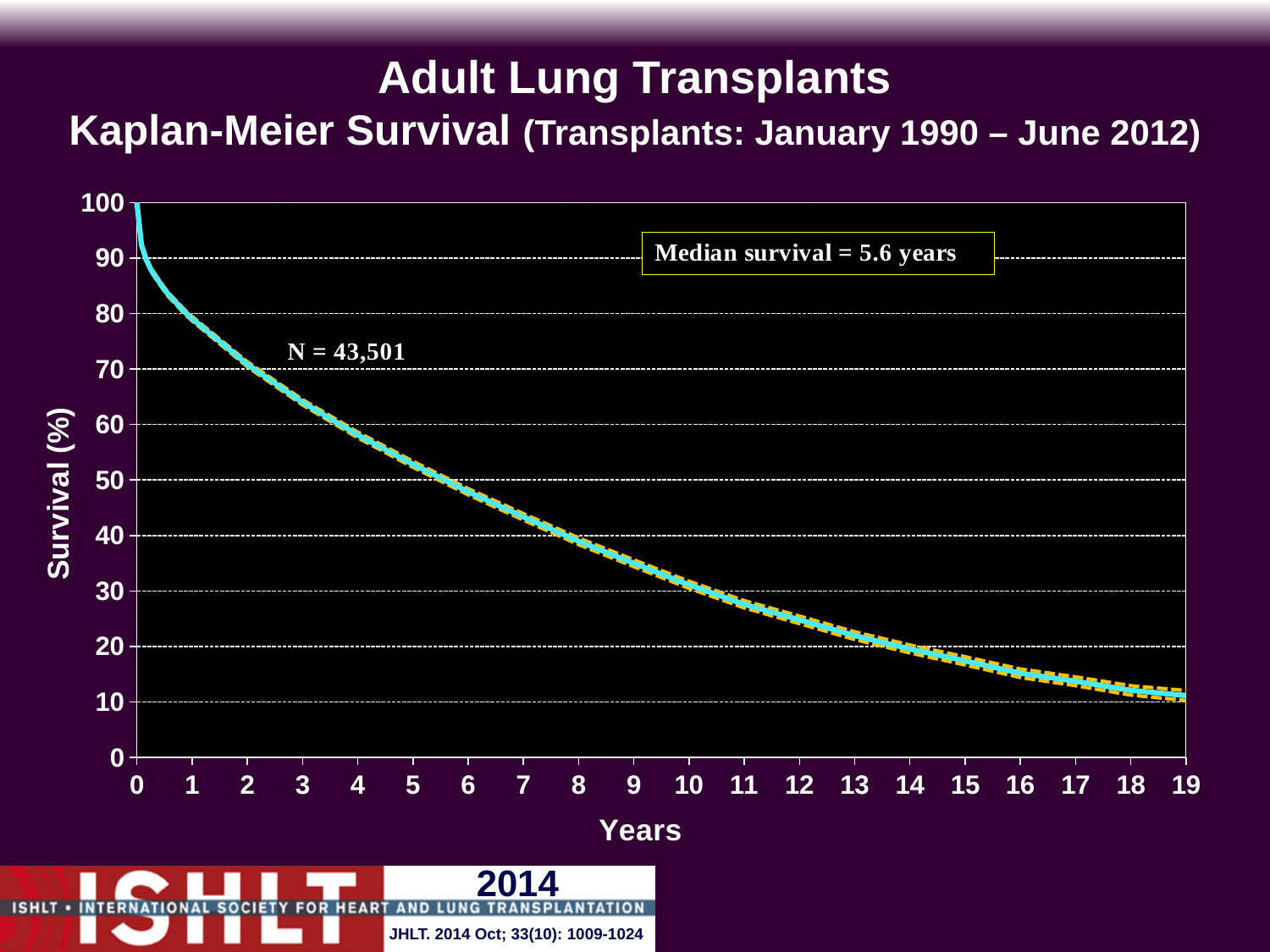
Is the survival value at year 19 greater or less than 20? less Is the survival value at year 3 greater or less than 60? greater What is the N (number of transplants) stated on the chart? 43,501 Is the survival value at year 19 greater or less than 10? greater What kind of chart is shown on the slide? line chart Does the survival curve rise or fall as the years increase along the x axis? fall What median survival is stated on the chart? 5.6 years What is the survival (%) at year 0 on the curve? 100